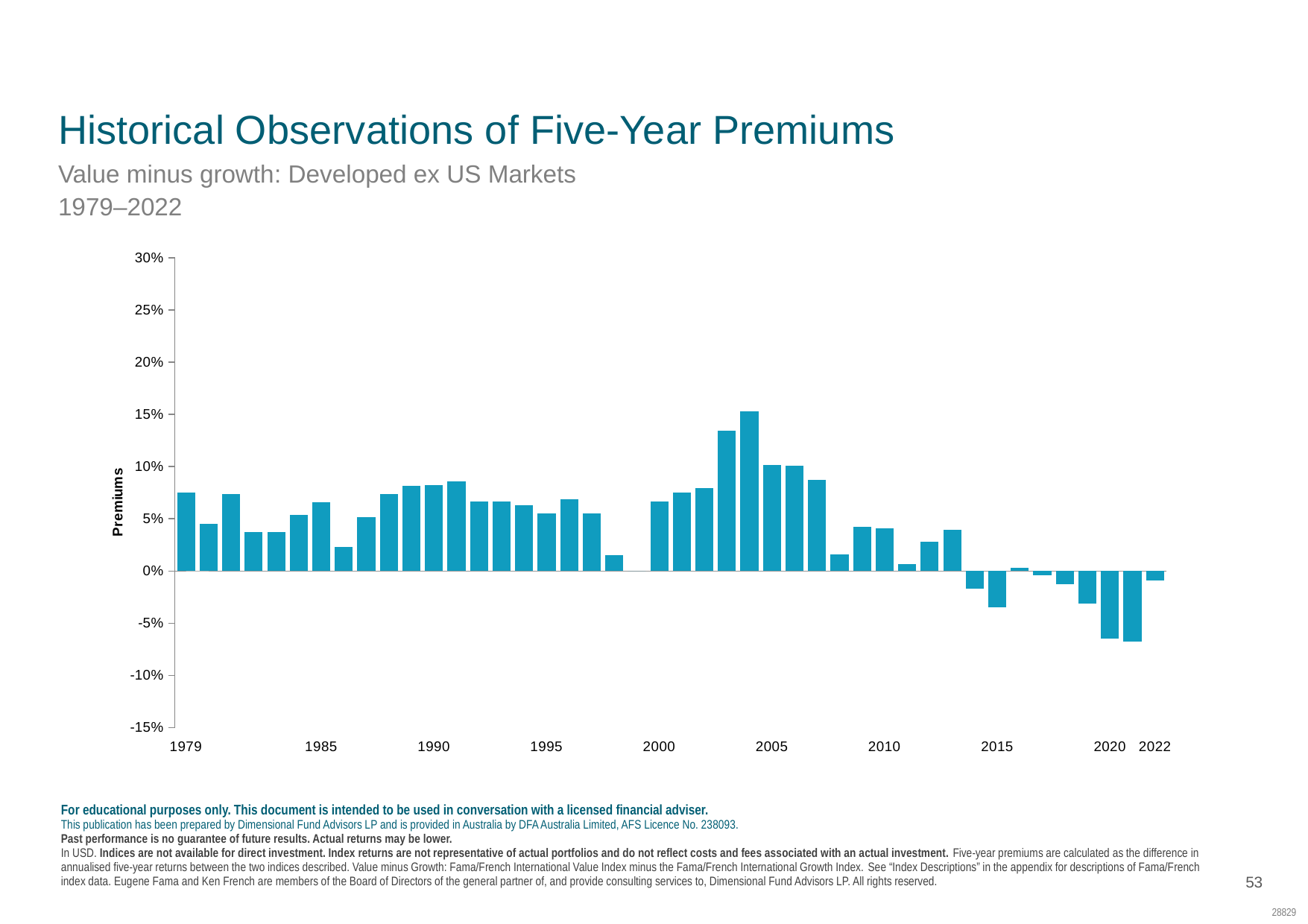
Which year has the larger value, 1990 or 2020? 1990 Is the value for 2010 greater or less than 5%? less Between 2005 and 2010, do the values generally rise or fall? fall Which year has the larger value, 2005 or 2010? 2005 Is the value for 1979 greater or less than 5%? greater Is the value for 2005 greater or less than 15%? less What kind of chart is shown on the slide? Bar chart What is the label on the vertical axis of the chart? Premiums